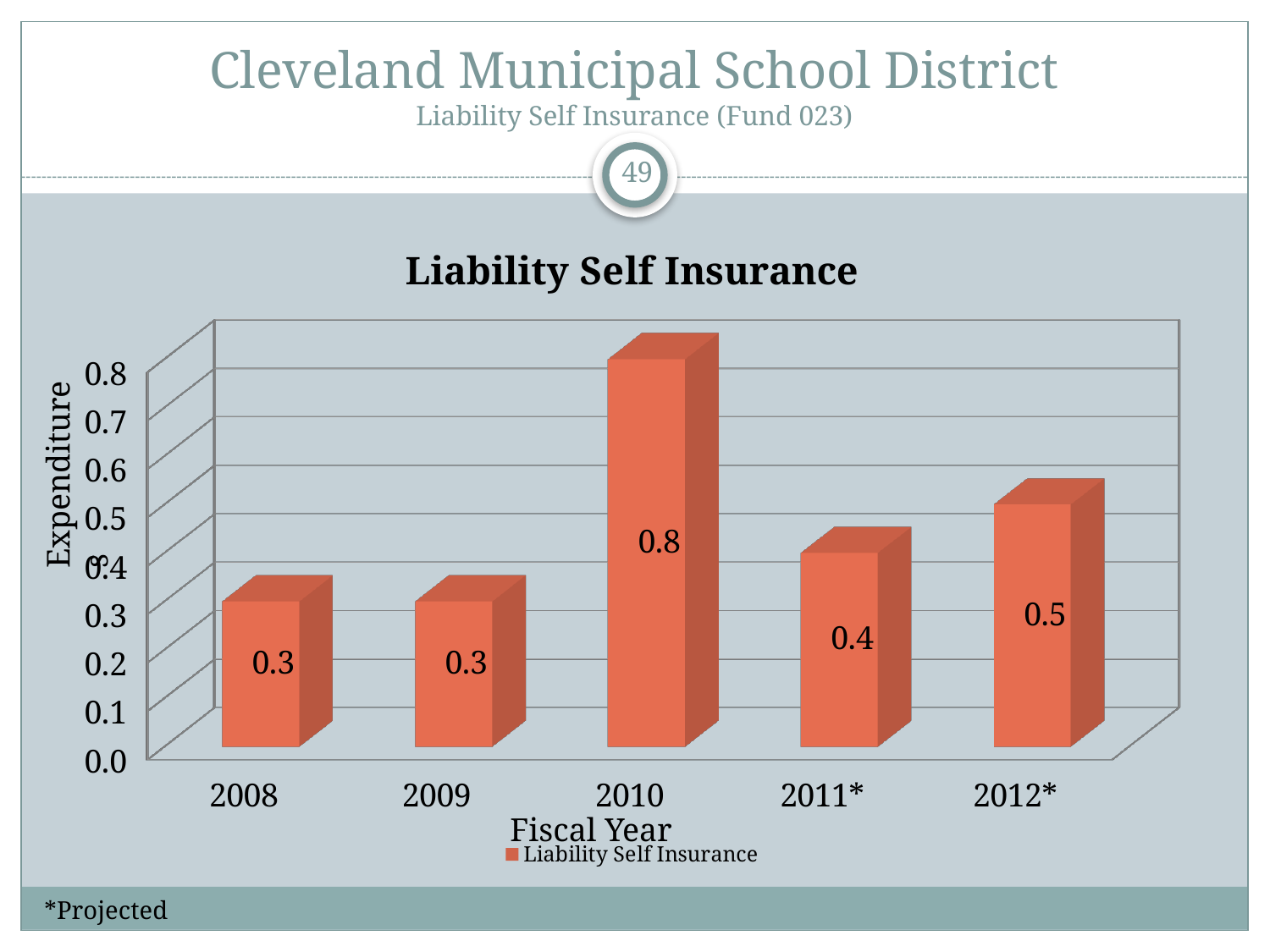
What is the value for 2012*? 0.5 How many fiscal years are shown on the x axis? 5 Which is larger, the value for 2011* or the value for 2012*? 2012* What is the difference between the values for 2010 and 2011*? 0.4 What is the value for 2011*? 0.4 What is the value for 2010? 0.8 What is the title of the chart? Liability Self Insurance What is the difference between the values for 2012* and 2008? 0.2 What kind of chart is shown? bar chart What is the label of the x axis? Fiscal Year Which fiscal year has the highest expenditure? 2010 How many series does the legend list? 1